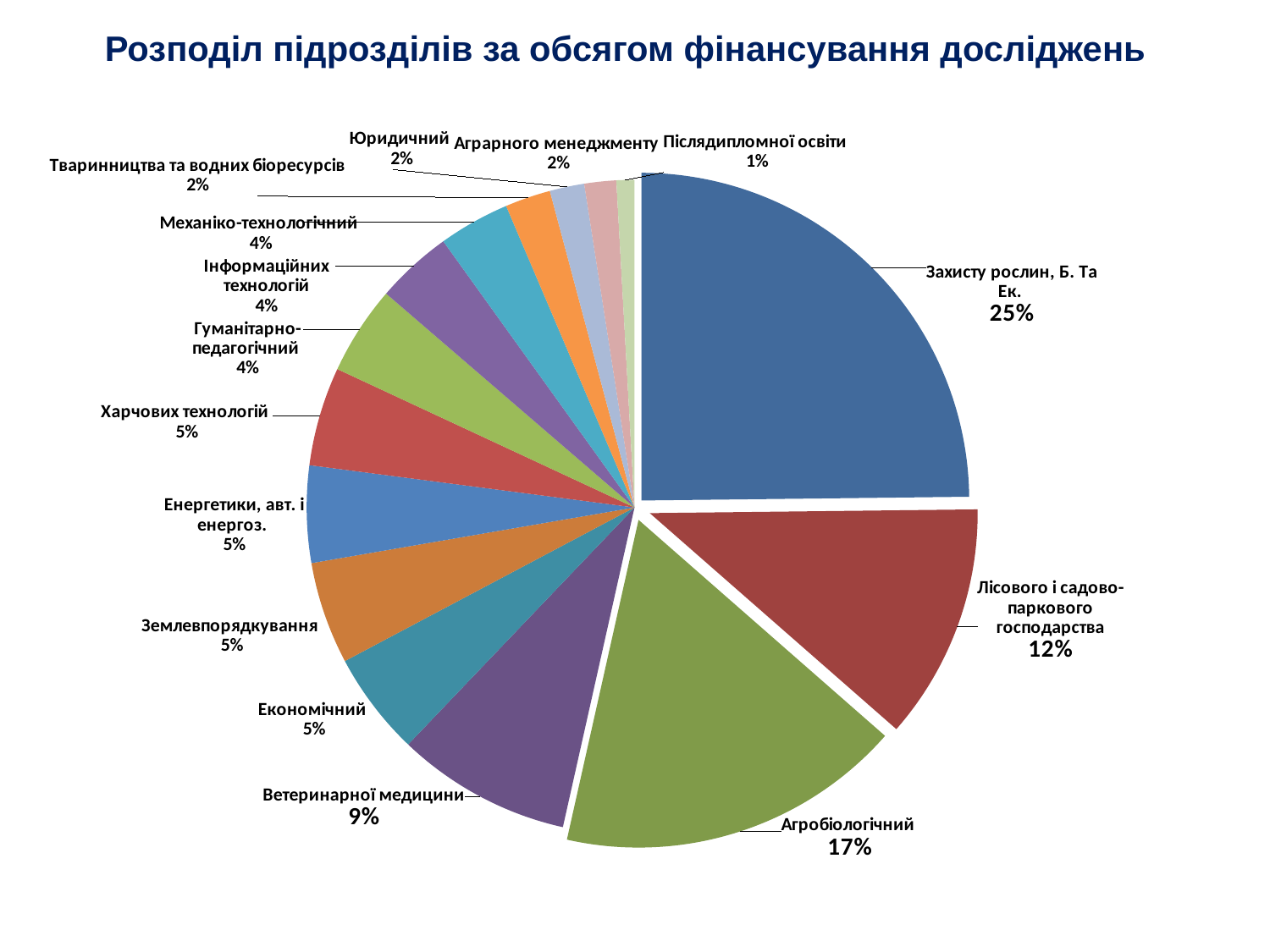
Which category has the largest slice of the pie? Захисту рослин, Б. Та Ек. What kind of chart is shown on the slide? pie chart What is the value for Післядипломної освіти? 1% What is the title of the chart? Розподіл підрозділів за обсягом фінансування досліджень Which category has the smallest slice of the pie? Післядипломної освіти What share of the pie does Агробіологічний have? 17% What is the value for Ветеринарної медицини? 9% What share of the pie does Лісового і садово-паркового господарства have? 12% What share of the pie does Захисту рослин, Б. Та Ек. have? 25% How many slices does the pie chart have? 15 What is the difference between the shares of Захисту рослин, Б. Та Ек. and Агробіологічний? 8% Which is larger, the share for Лісового і садово-паркового господарства or the share for Ветеринарної медицини? Лісового і садово-паркового господарства